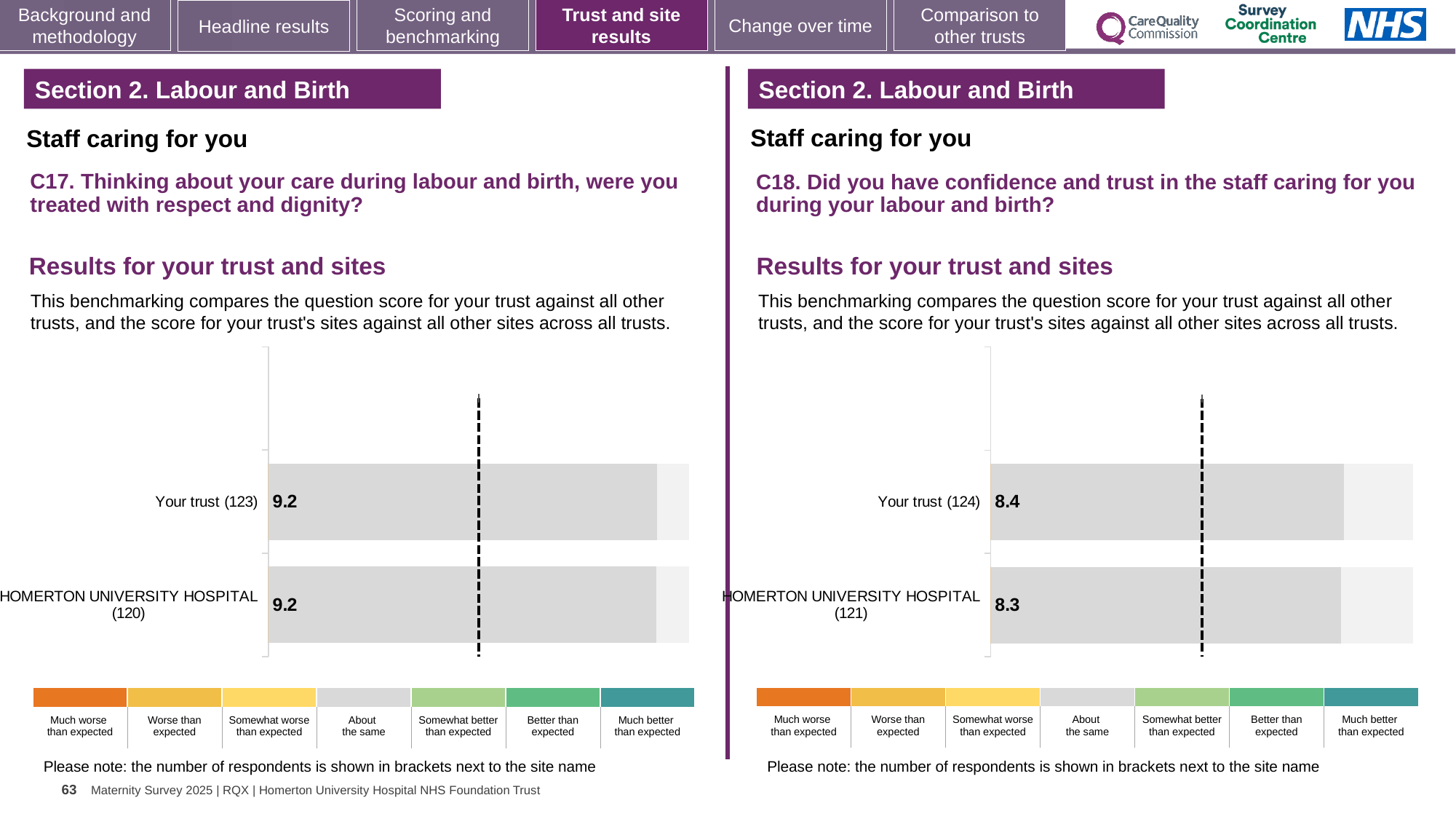
In the left chart (C17), how many respondents are shown in brackets for Your trust? 123 In the right chart (C18), what is the score for Homerton University Hospital? 8.3 What type of chart is used for the C18 results on the right? Bar chart In the left chart (C17), what is the score for Homerton University Hospital? 9.2 How many bars are plotted in the right chart (C18)? 2 In the left chart (C17), what is the difference between the Your trust score and the Homerton University Hospital score? 0 Is the Your trust score in the right chart (C18) greater or less than the Your trust score in the left chart (C17)? less In the right chart (C18), what is the difference between the Your trust score and the Homerton University Hospital score? 0.1 In the right chart (C18), what is the score for Your trust? 8.4 In the right chart (C18), how many respondents are shown in brackets for Homerton University Hospital? 121 In the left chart (C17), what is the score for Your trust? 9.2 How many bars are plotted in the left chart (C17)? 2